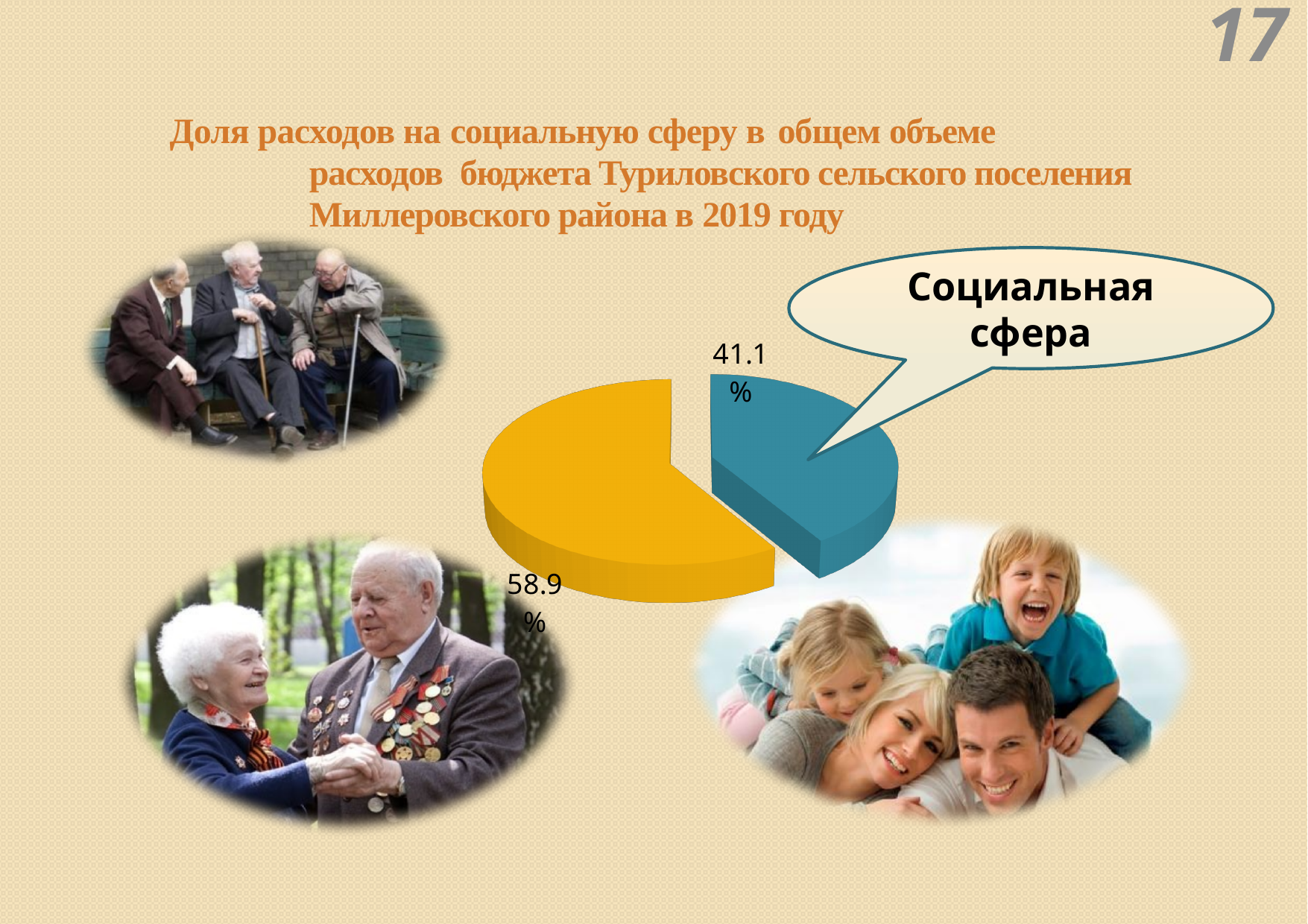
What share of budget expenditure does the slice labelled "Социальная сфера" represent? 41.1% What value is printed on the blue slice of the pie chart? 41.1% What is the difference in percentage points between the yellow slice and the blue slice? 17.8 Which slice does the callout "Социальная сфера" point to, the blue one or the yellow one? the blue one What kind of chart is shown on the slide? pie chart What value is printed on the yellow slice of the pie chart? 58.9% Which slice of the pie chart is the smallest, the yellow one or the blue one? the blue one Is the value for "Социальная сфера" greater or less than 50%? less Is the share for "Социальная сфера" larger or smaller than the share of the yellow slice? smaller Which slice of the pie chart is the largest, the yellow one or the blue one? the yellow one How many slices does the pie chart have? 2 Which year does the chart title say the data refers to? 2019